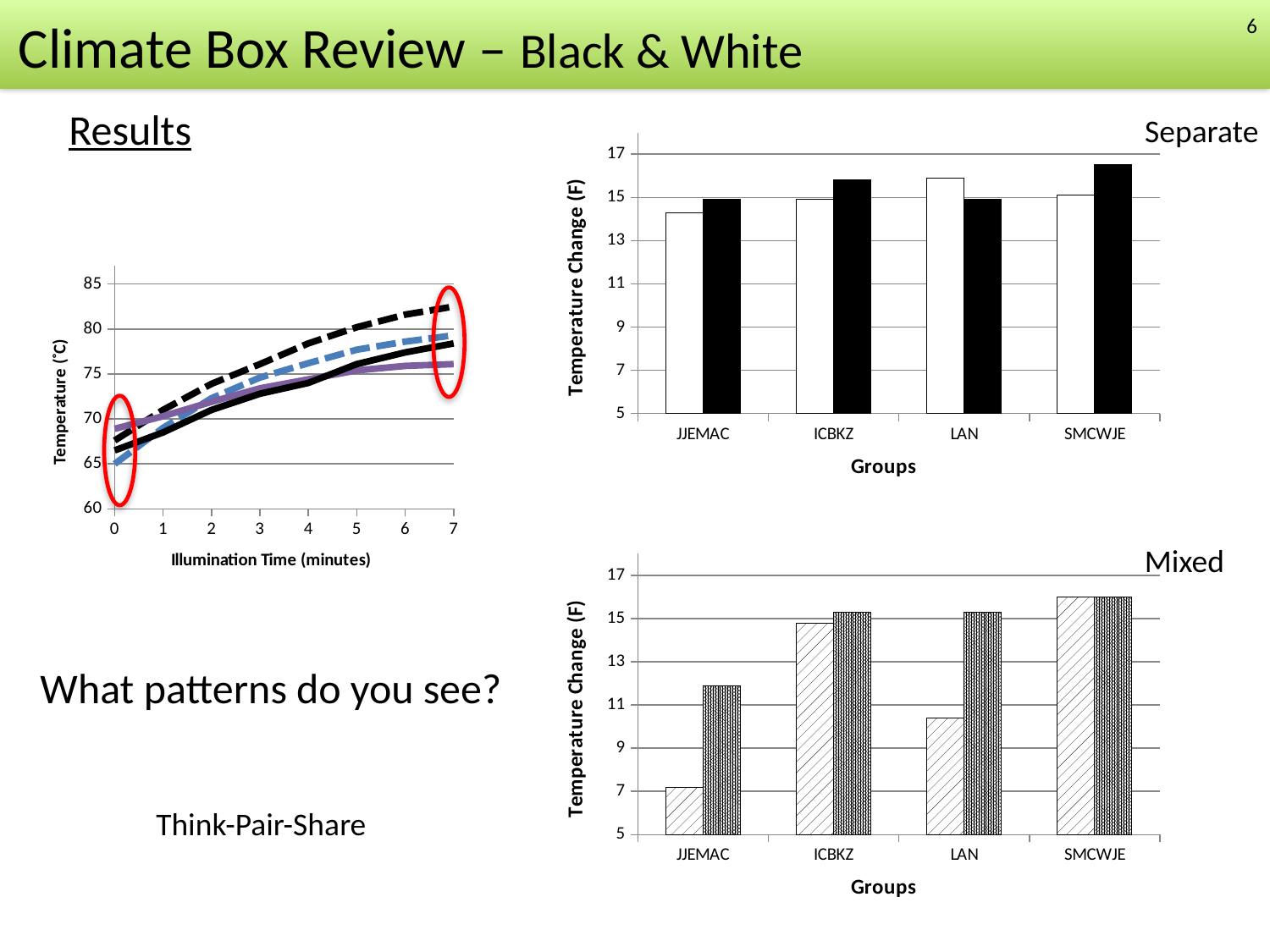
In the Separate chart, is the black bar for SMCWJE greater or less than 15? greater What is the x-axis title of the Mixed chart? Groups In the Separate chart, which group has the tallest bar? SMCWJE What kind of chart is the Separate chart at the top right? bar chart In the Separate chart, is the white bar for JJEMAC greater or less than 15? less In the line chart on the left, do the temperatures rise or fall as illumination time increases from 0 to 7 minutes? rise What is the y-axis label of the line chart on the left? Temperature (°C) In the Mixed chart, is the hatched bar for LAN greater or less than 11? less How many groups are shown on the x axis of the Separate chart? 4 In the Mixed chart, which group has the lowest bar? JJEMAC What kind of chart is the chart on the left with the x axis labelled Illumination Time (minutes)? line chart In the Mixed chart, which is larger for JJEMAC: the hatched bar or the dotted bar? the dotted bar